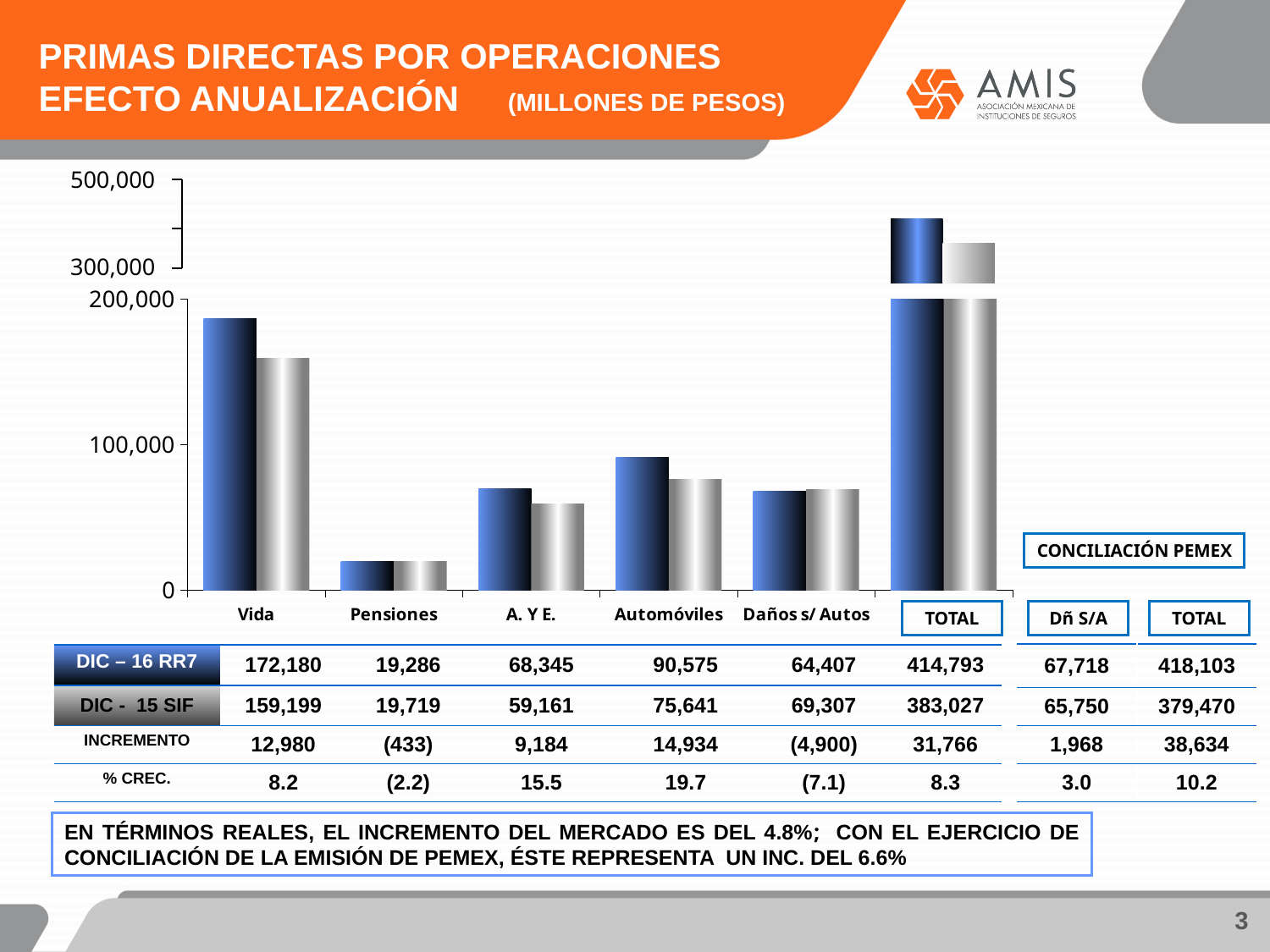
What is the DIC – 16 RR7 value for TOTAL? 414,793 Which category has the lowest DIC - 15 SIF value? Pensiones Excluding TOTAL, which category has the highest DIC – 16 RR7 value? Vida What kind of chart is shown on the slide? bar chart What is the difference between the DIC – 16 RR7 and DIC - 15 SIF values for Vida? 12,980 What is the DIC – 16 RR7 value for Vida? 172,180 What is the DIC - 15 SIF value for Automóviles? 75,641 Is the DIC – 16 RR7 value for A. Y E. greater or less than 100,000? less What is the DIC – 16 RR7 value for Daños s/ Autos? 64,407 For Daños s/ Autos, which is larger: the DIC – 16 RR7 value or the DIC - 15 SIF value? DIC - 15 SIF How many data series are plotted in the chart? 2 How many categories are shown on the x axis of the chart? 6